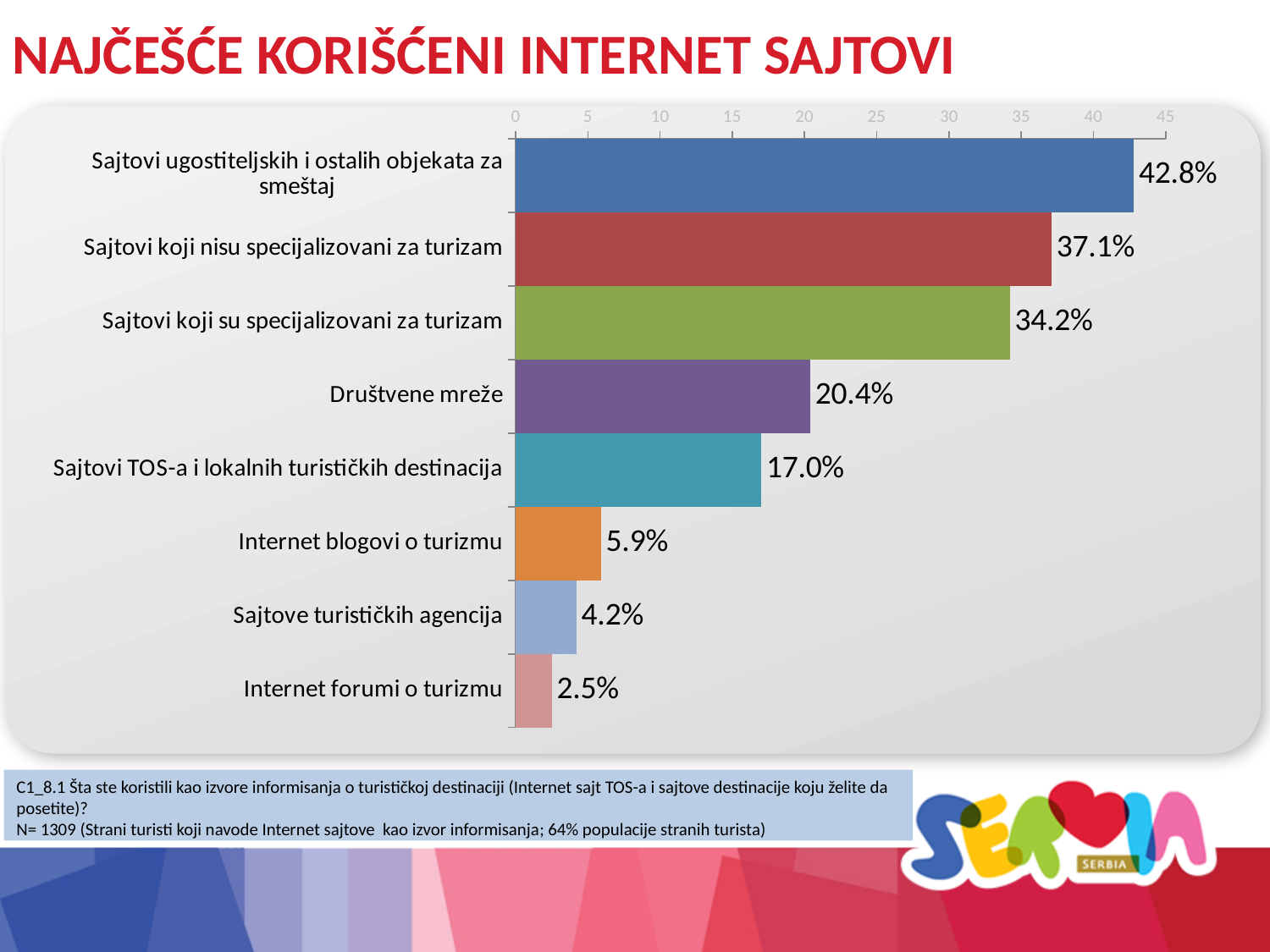
What is the value for "Internet forumi o turizmu"? 2.5% Which category has the lowest value? Internet forumi o turizmu Which category has the highest value? Sajtovi ugostiteljskih i ostalih objekata za smeštaj What is the maximum value shown on the horizontal axis? 45 What is the value for "Sajtovi koji nisu specijalizovani za turizam"? 37.1% How many categories are shown in the chart? 8 Which is larger: the value for "Internet blogovi o turizmu" or the value for "Sajtove turističkih agencija"? Internet blogovi o turizmu What is the difference between the values for "Sajtovi koji su specijalizovani za turizam" and "Sajtovi TOS-a i lokalnih turističkih destinacija"? 17.2% What kind of chart is shown on the slide? bar chart Is the value for "Sajtovi ugostiteljskih i ostalih objekata za smeštaj" greater or less than 40? greater What is the title of the slide? NAJČEŠĆE KORIŠĆENI INTERNET SAJTOVI What is the value for "Društvene mreže"? 20.4%